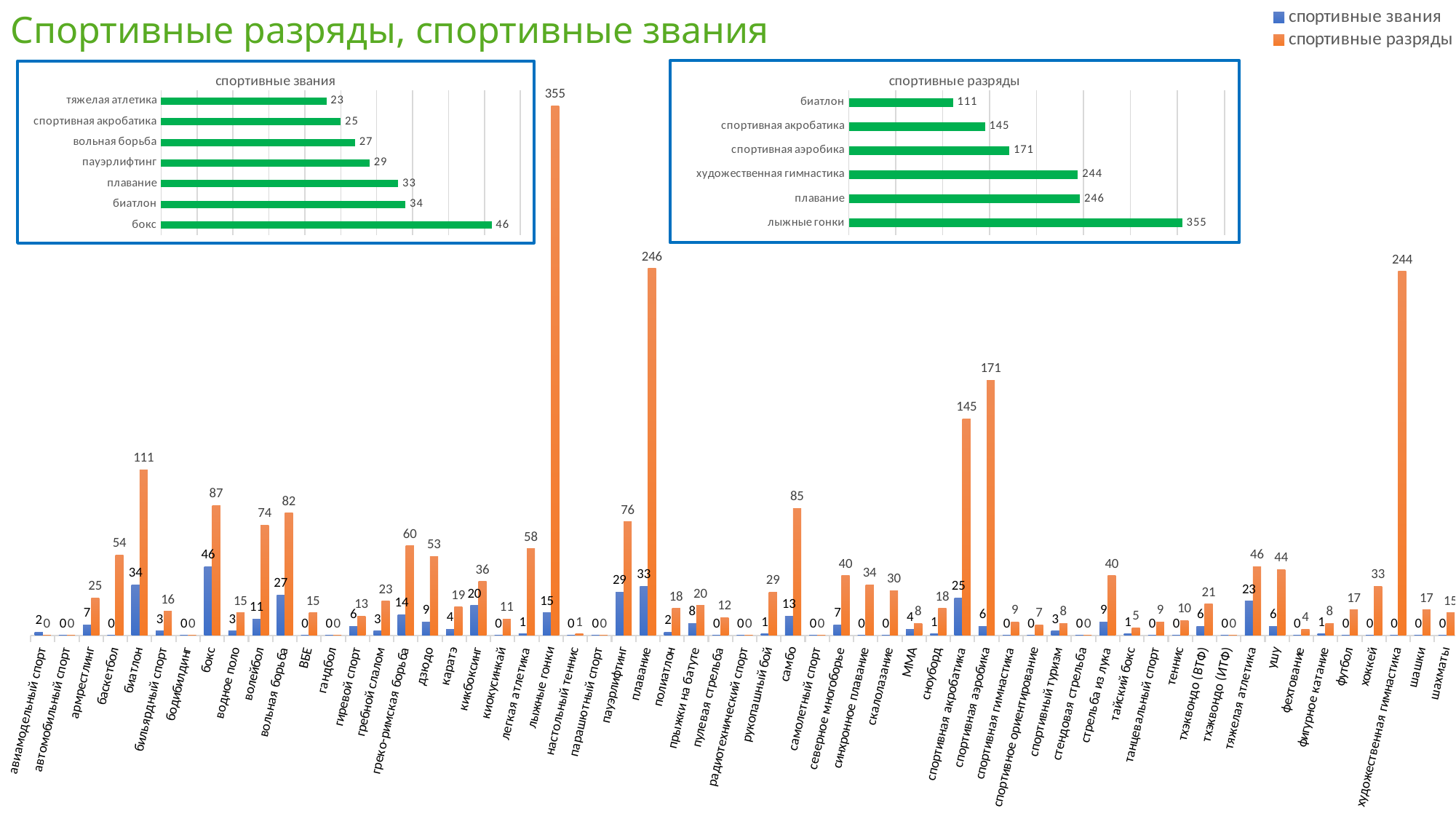
In the large chart at the bottom of the slide, what is the difference between 'спортивные разряды' and 'спортивные звания' for 'плавание'? 213 In the inset chart titled 'спортивные разряды', which category has the lowest value? биатлон In the inset chart titled 'спортивные разряды', how many categories are shown? 6 In the inset chart titled 'спортивные звания', what is the value for 'пауэрлифтинг'? 29 In the large chart at the bottom of the slide, what is the value of 'спортивные разряды' for 'лыжные гонки'? 355 In the inset chart titled 'спортивные разряды', what is the difference between the values for 'лыжные гонки' and 'плавание'? 109 In the inset chart titled 'спортивные звания', how many categories are shown? 7 What kind of chart is the large chart at the bottom of the slide? bar chart In the large chart at the bottom of the slide, which has the larger 'спортивные разряды' value: 'биатлон' or 'бокс'? биатлон In the inset chart titled 'спортивные звания', which category has the highest value? бокс In the large chart at the bottom of the slide, what is the value of 'спортивные звания' for 'бокс'? 46 In the large chart at the bottom of the slide, how many series does the legend list? 2